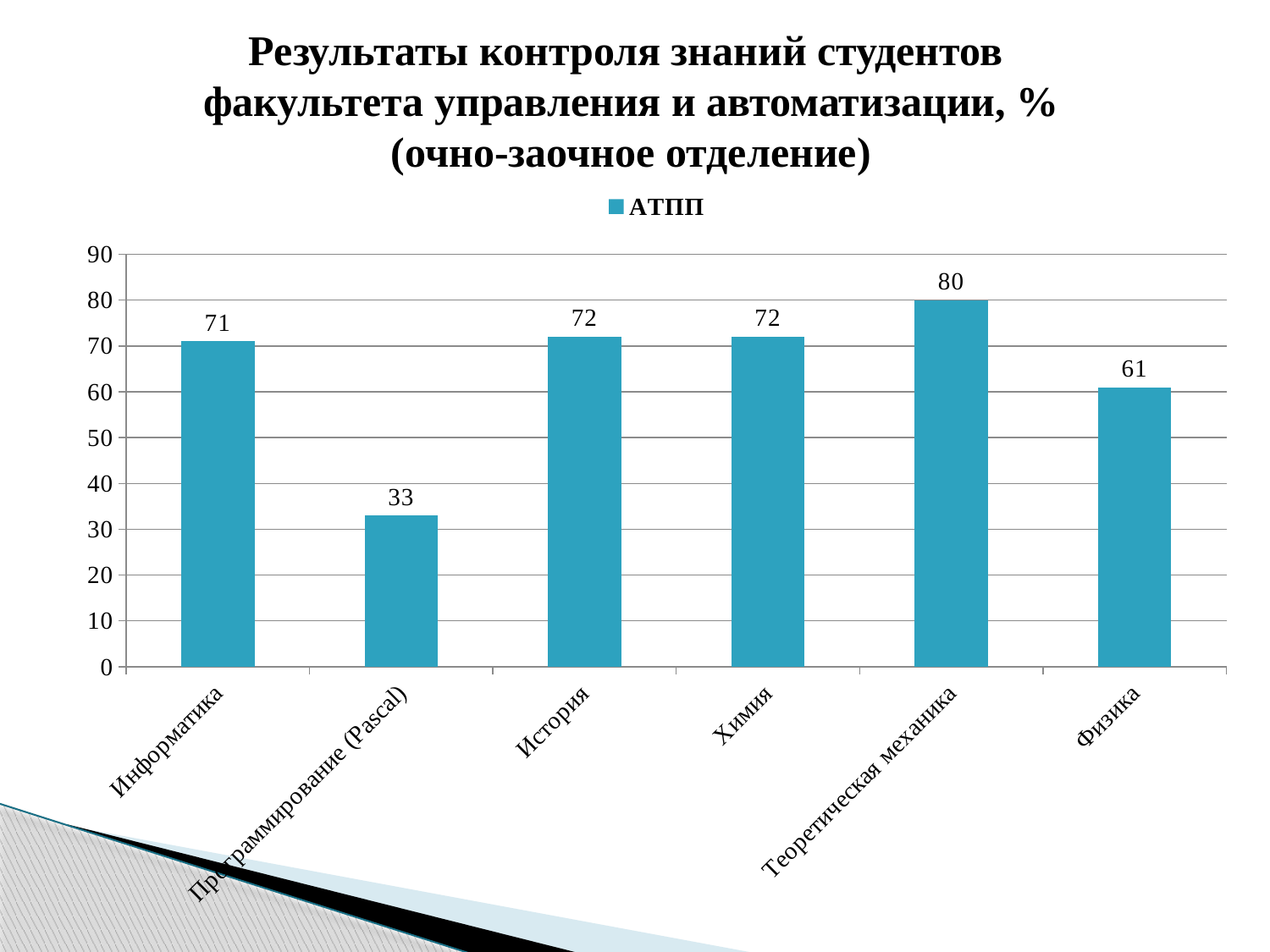
What is the difference between the values for Теоретическая механика and Программирование (Pascal)? 47 What is the difference between the values for История and Физика? 11 What series name does the legend show? АТПП What is the value for Физика? 61 What kind of chart is shown on the slide? bar chart What is the value for Теоретическая механика? 80 What is the value for Информатика? 71 Which category has the highest value? Теоретическая механика How many categories are shown on the x axis? 6 Which category has the lowest value? Программирование (Pascal) What is the value for Программирование (Pascal)? 33 Which is larger, the value for Информатика or the value for Физика? Информатика